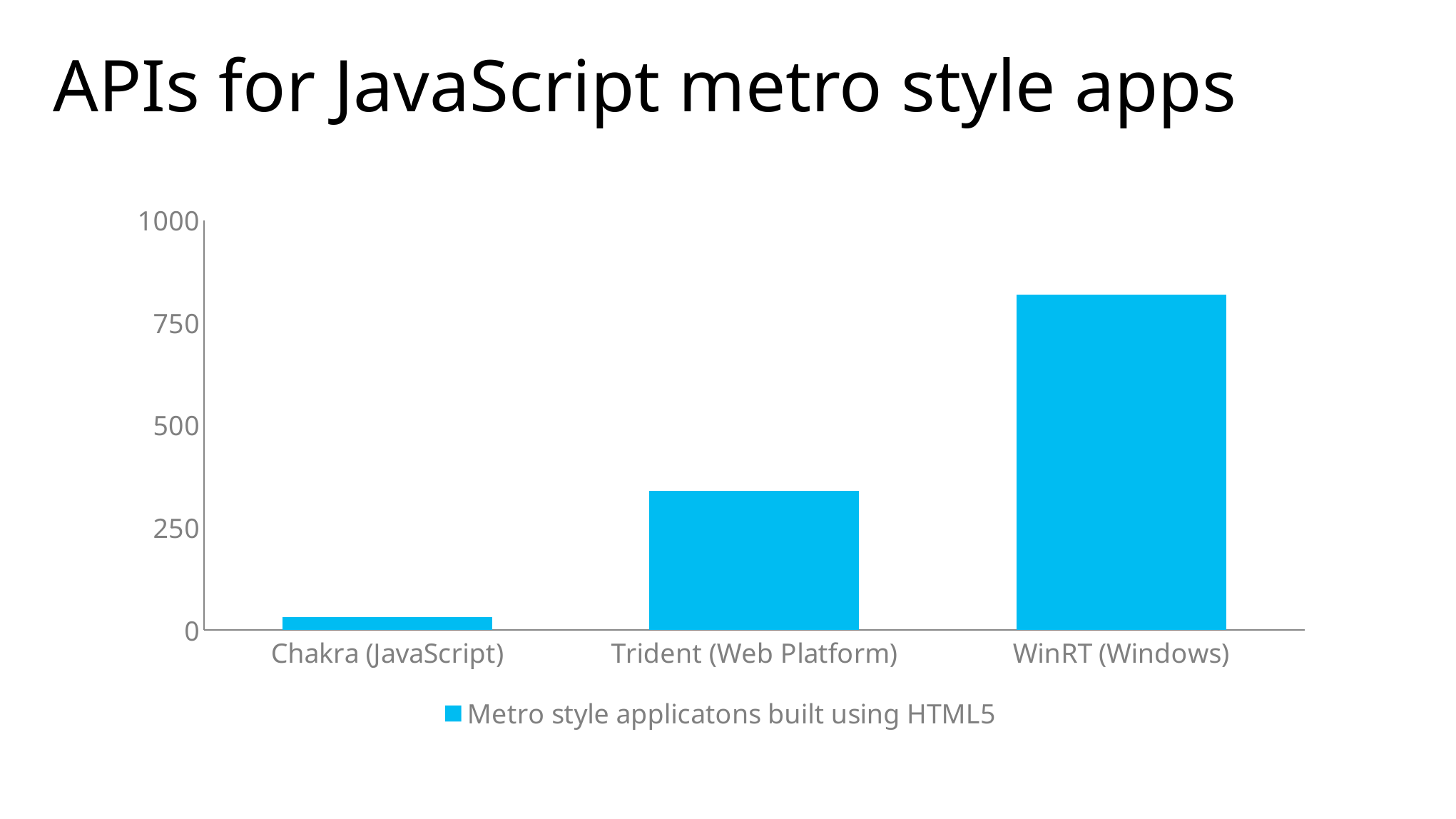
Which is larger, the value for WinRT (Windows) or the value for Trident (Web Platform)? WinRT (Windows) Is the value for WinRT (Windows) greater or less than 750? greater Is the value for Trident (Web Platform) greater or less than 250? greater Which category has the lowest value? Chakra (JavaScript) How many categories are shown on the x axis? 3 What kind of chart is shown on the slide? bar chart What is the legend entry for the series shown? Metro style applicatons built using HTML5 Is the value for Chakra (JavaScript) greater or less than 250? less Which category has the highest value? WinRT (Windows) Which is larger, the value for Trident (Web Platform) or the value for Chakra (JavaScript)? Trident (Web Platform) How many series does the legend list? 1